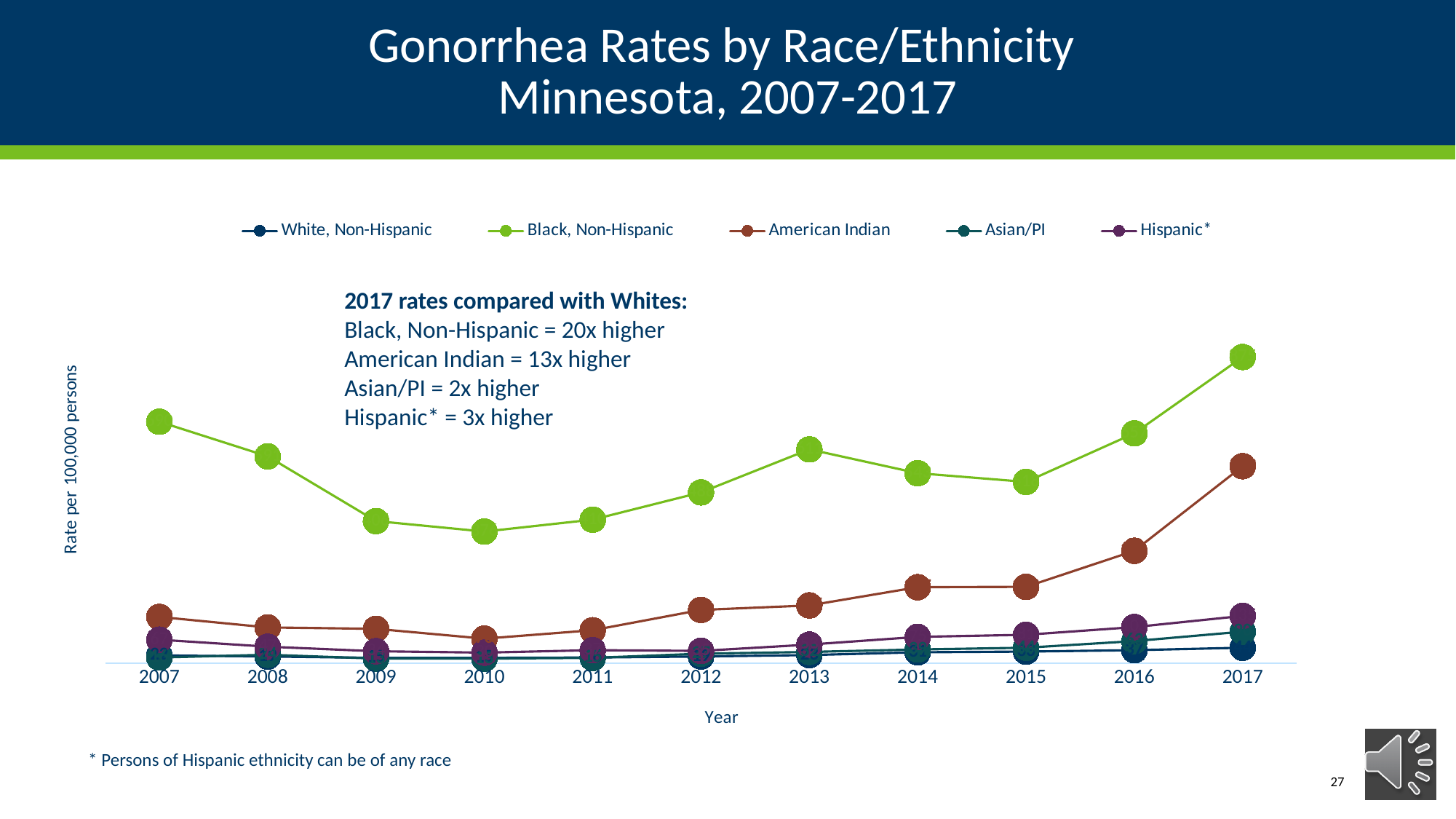
What kind of chart is shown on the slide? Line chart In which year is the Black, Non-Hispanic rate at its lowest? 2010 Which is larger in 2007, the Black, Non-Hispanic rate or the American Indian rate? Black, Non-Hispanic Which race/ethnicity group has the highest gonorrhea rate in 2017? Black, Non-Hispanic How many series does the legend list? 5 Which race/ethnicity group has the lowest gonorrhea rate in 2017? White, Non-Hispanic How many years are plotted along the x axis? 11 Which is larger in 2017, the American Indian rate or the Hispanic rate? American Indian Does the American Indian rate rise or fall from 2013 to 2017? Rise In which year is the Black, Non-Hispanic rate at its highest? 2017 What is the label on the y axis of the chart? Rate per 100,000 persons Does the Black, Non-Hispanic rate rise or fall from 2007 to 2010? Fall